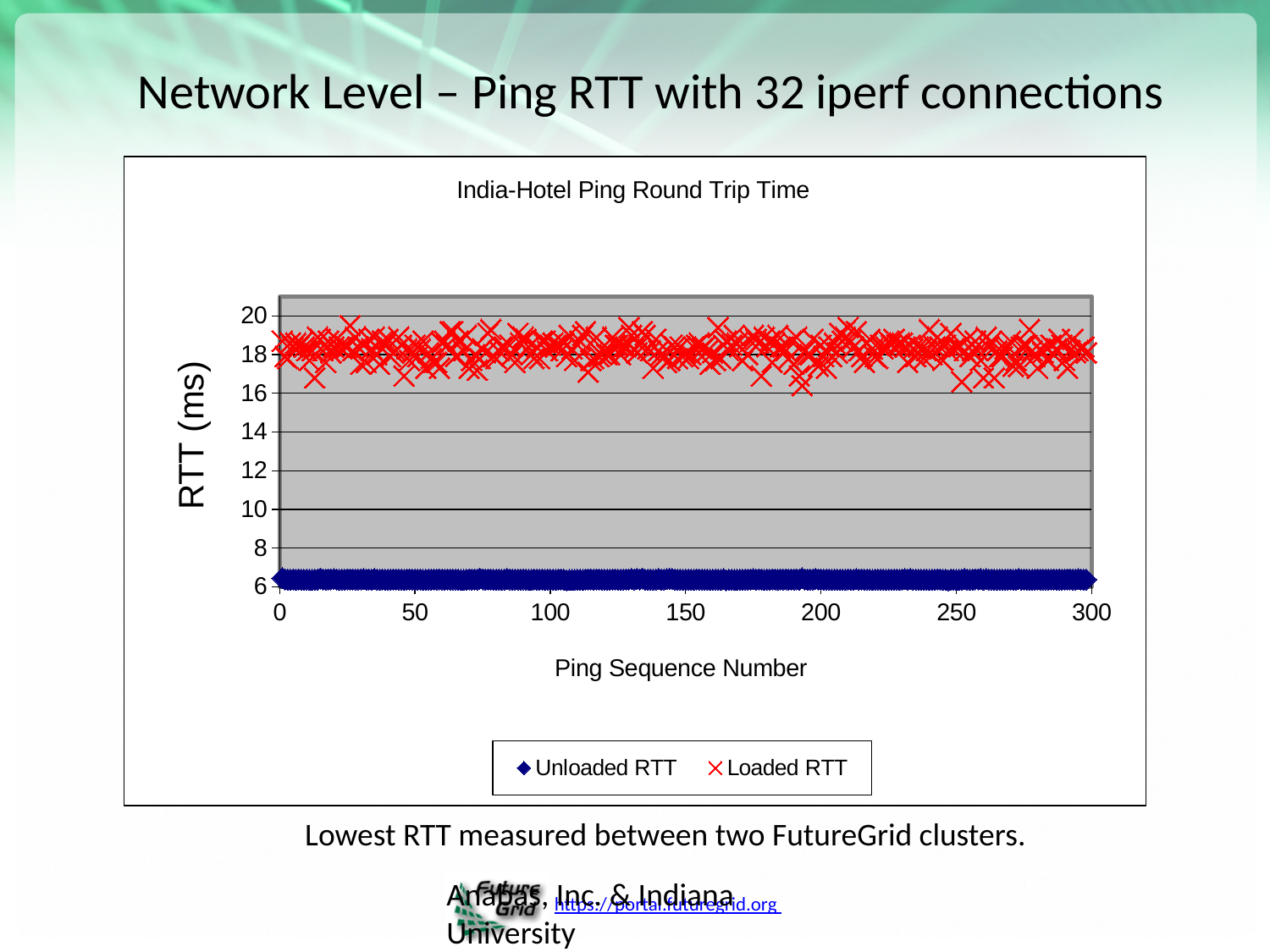
Do the Unloaded RTT values rise, fall, or stay roughly flat as the ping sequence number increases? stay roughly flat Are the Unloaded RTT values greater or less than 10 ms? less Are the Loaded RTT values greater or less than 20 ms? less Are the Unloaded RTT values greater or less than 8 ms? less How many series does the chart's legend list? 2 Which series has the higher RTT values, Unloaded RTT or Loaded RTT? Loaded RTT What kind of chart is shown on the slide? scatter chart What is the label of the y axis? RTT (ms) What is the label of the x axis? Ping Sequence Number What is the title of the chart? India-Hotel Ping Round Trip Time